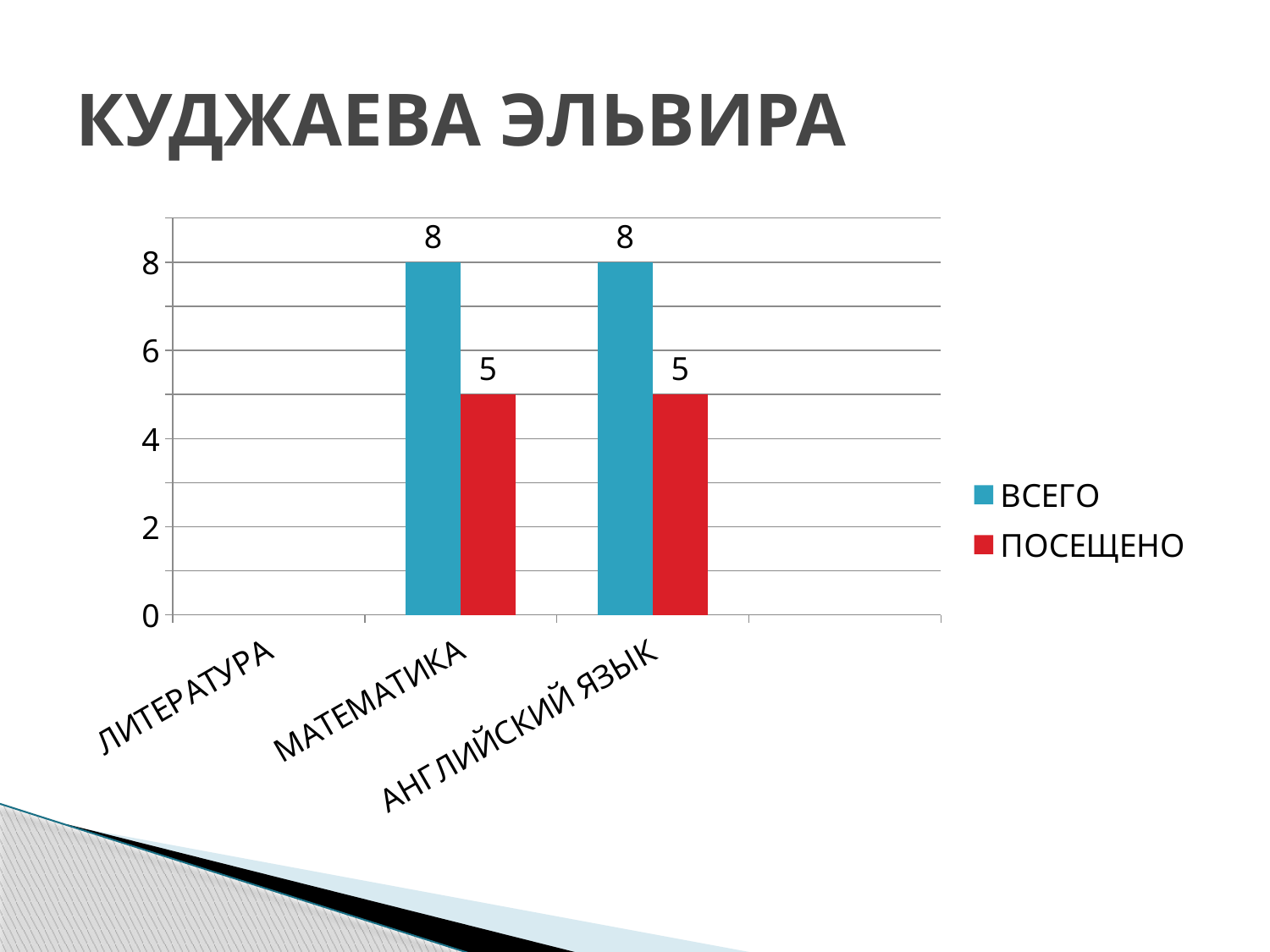
What is the difference between the ВСЕГО and ПОСЕЩЕНО values for МАТЕМАТИКА? 3 Which is larger for АНГЛИЙСКИЙ ЯЗЫК, the ВСЕГО value or the ПОСЕЩЕНО value? ВСЕГО How many categories are shown on the x axis? 3 Is the ПОСЕЩЕНО value for МАТЕМАТИКА greater or less than 6? less What kind of chart is shown on the slide? bar chart What colour are the ПОСЕЩЕНО bars? red How many series does the legend list? 2 What is the ПОСЕЩЕНО value for АНГЛИЙСКИЙ ЯЗЫК? 5 What is the ВСЕГО value for МАТЕМАТИКА? 8 What is the ПОСЕЩЕНО value for МАТЕМАТИКА? 5 Which category has no bars plotted? ЛИТЕРАТУРА What is the ВСЕГО value for АНГЛИЙСКИЙ ЯЗЫК? 8